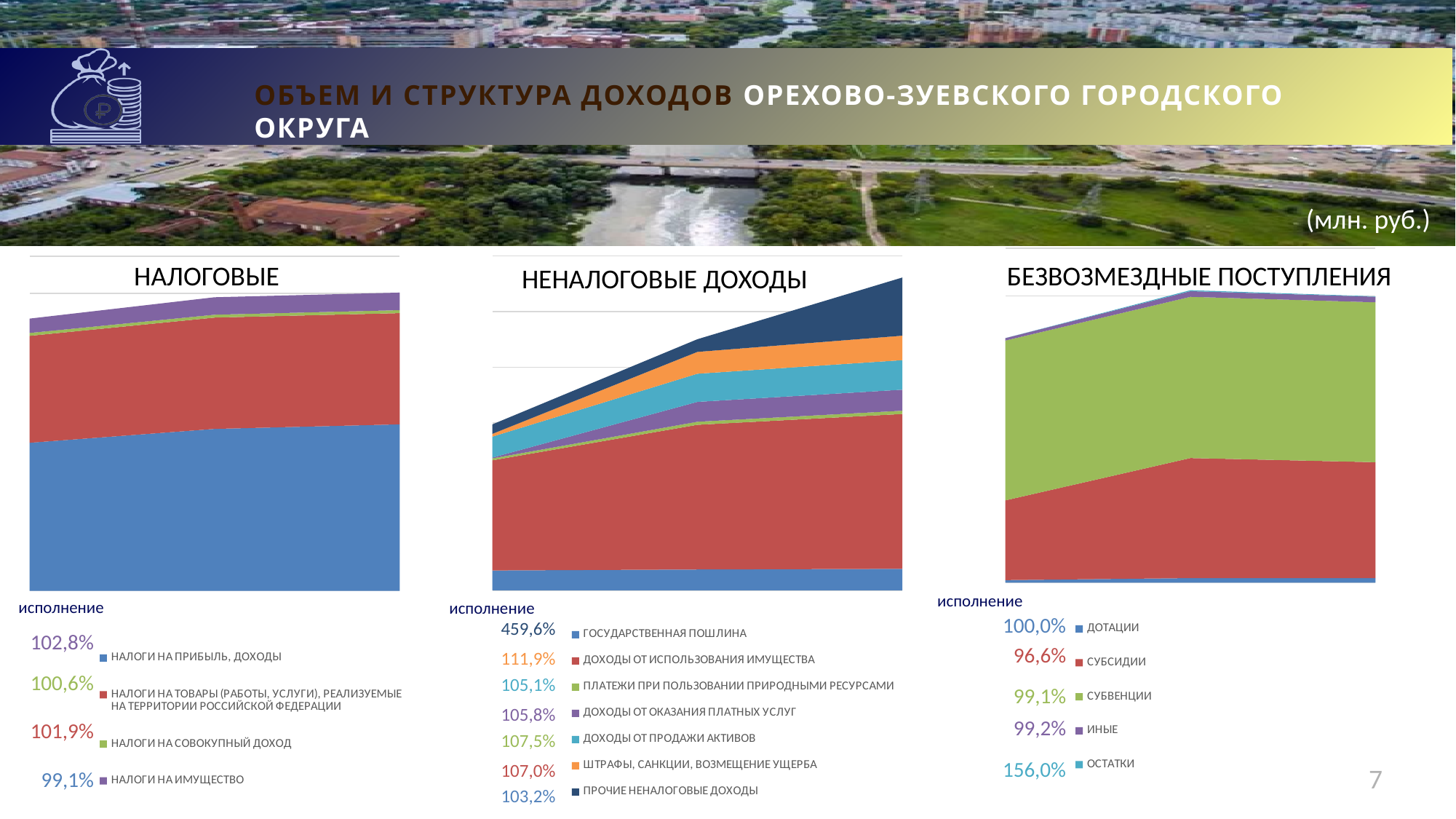
In the БЕЗВОЗМЕЗДНЫЕ ПОСТУПЛЕНИЯ chart, what is the исполнение value shown for СУБСИДИИ? 96,6% In the БЕЗВОЗМЕЗДНЫЕ ПОСТУПЛЕНИЯ chart, which legend entry has the highest исполнение value? ОСТАТКИ What kind of chart is the НАЛОГОВЫЕ chart? Stacked area chart In the НЕНАЛОГОВЫЕ ДОХОДЫ chart, what is the исполнение value shown for ГОСУДАРСТВЕННАЯ ПОШЛИНА? 459,6% In the НЕНАЛОГОВЫЕ ДОХОДЫ chart, does the total stacked area rise or fall along the x axis? Rise How many series does the legend of the НАЛОГОВЫЕ chart list? 4 How many series does the legend of the НЕНАЛОГОВЫЕ ДОХОДЫ chart list? 7 In the НАЛОГОВЫЕ chart, what is the исполнение value shown for НАЛОГИ НА ПРИБЫЛЬ, ДОХОДЫ? 102,8% How many series does the legend of the БЕЗВОЗМЕЗДНЫЕ ПОСТУПЛЕНИЯ chart list? 5 In the НЕНАЛОГОВЫЕ ДОХОДЫ chart, which has the larger исполнение value: ДОХОДЫ ОТ ПРОДАЖИ АКТИВОВ or ШТРАФЫ, САНКЦИИ, ВОЗМЕЩЕНИЕ УЩЕРБА? ДОХОДЫ ОТ ПРОДАЖИ АКТИВОВ In the НАЛОГОВЫЕ chart, which legend entry has the lowest исполнение value? НАЛОГИ НА ИМУЩЕСТВО In the БЕЗВОЗМЕЗДНЫЕ ПОСТУПЛЕНИЯ chart, which colour represents СУБВЕНЦИИ? Green